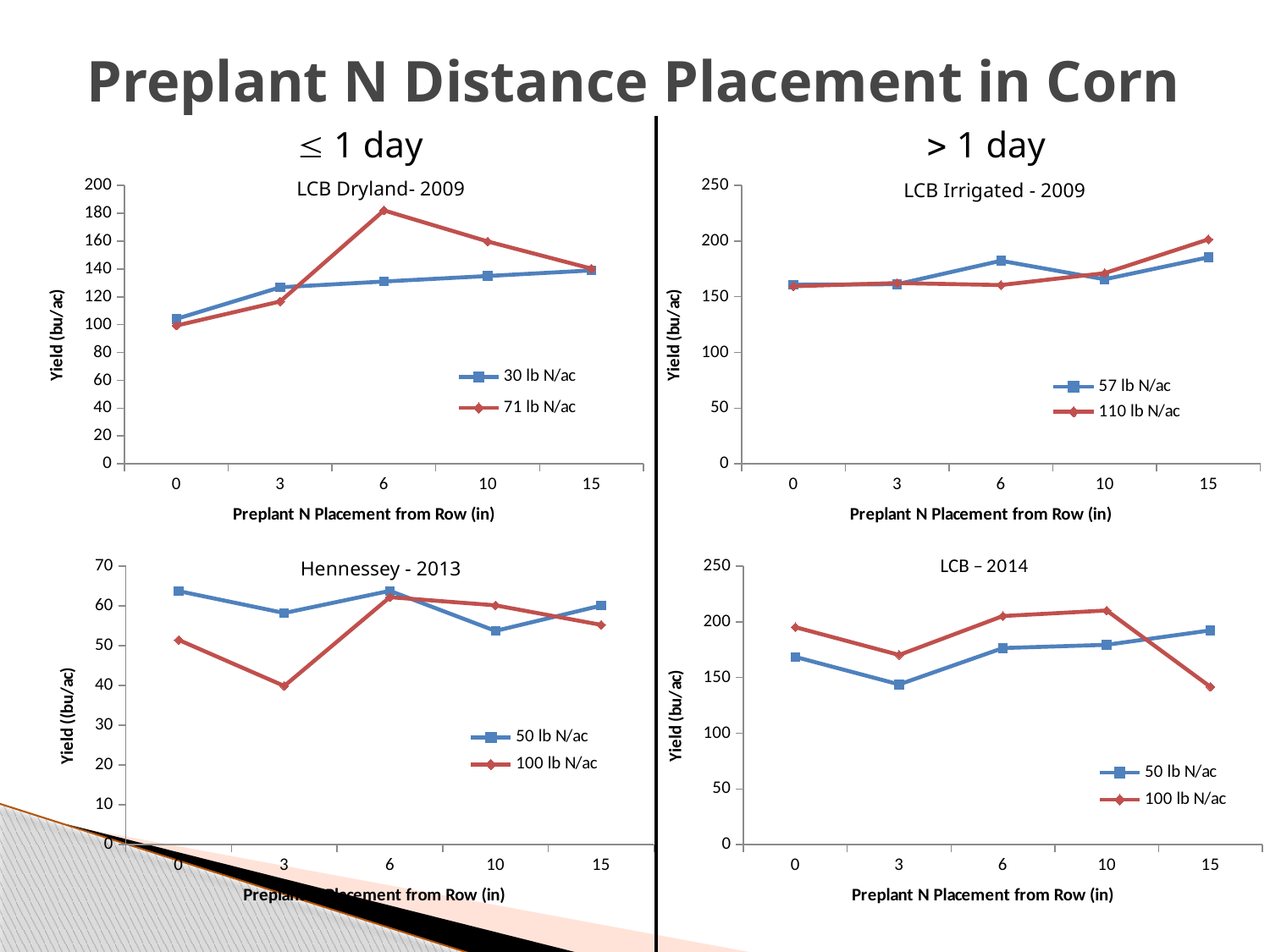
In the LCB Irrigated - 2009 chart, is the yield for 110 lb N/ac at 15 in greater or less than 150? greater What are the two legend entries in the LCB Irrigated - 2009 chart? 57 lb N/ac and 110 lb N/ac In the Hennessey - 2013 chart, at which placement distance is the yield for 100 lb N/ac lowest? 3 In the LCB – 2014 chart, is the yield for 100 lb N/ac at 10 in greater or less than 200? greater In the LCB – 2014 chart, at which placement distance is the yield for 100 lb N/ac highest? 10 How many charts are shown on the slide? 4 In the LCB – 2014 chart, at 15 in, which series has the higher yield, 50 lb N/ac or 100 lb N/ac? 50 lb N/ac In the LCB Dryland- 2009 chart, at which placement distance is the yield for 71 lb N/ac highest? 6 What kind of chart is the LCB Dryland- 2009 chart? line chart How many placement distances are plotted along the x axis of the Hennessey - 2013 chart? 5 How many series does the legend of the LCB Dryland- 2009 chart list? 2 In the LCB Dryland- 2009 chart, is the yield for 71 lb N/ac at 6 in greater or less than 160? greater